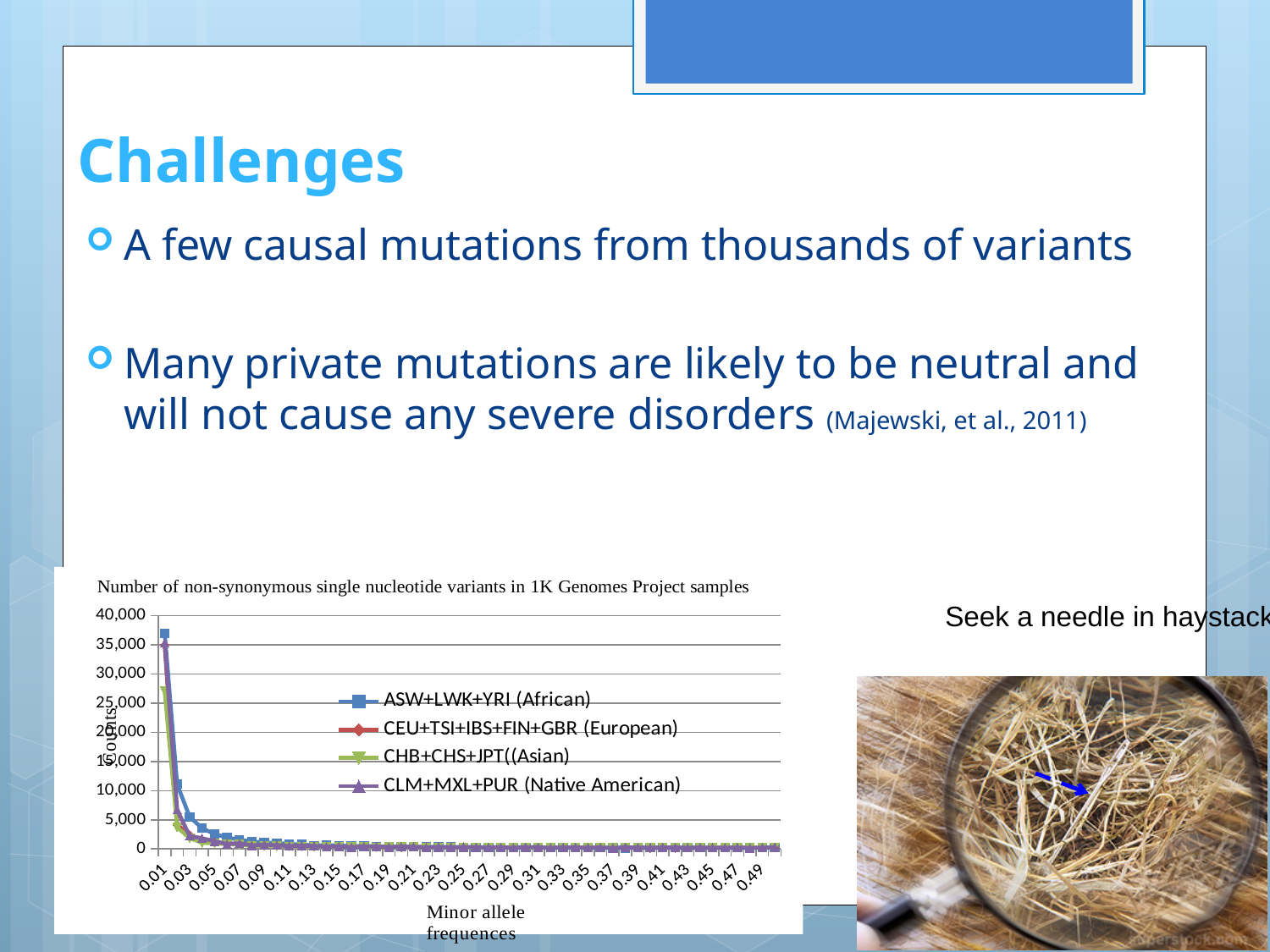
What is the highest value shown on the chart's y axis? 40,000 At minor allele frequency 0.01, which is larger: the count for ASW+LWK+YRI (African) or for CHB+CHS+JPT (Asian)? ASW+LWK+YRI (African) Is the value for CHB+CHS+JPT (Asian) at minor allele frequency 0.01 greater or less than 30,000? less Do the counts rise or fall as minor allele frequency increases along the x axis? fall What is the title of the chart? Number of non-synonymous single nucleotide variants in 1K Genomes Project samples Which legend entry is drawn with blue square markers? ASW+LWK+YRI (African) Which series has the lowest count at minor allele frequency 0.01? CHB+CHS+JPT (Asian) Is the value for CEU+TSI+IBS+FIN+GBR (European) at minor allele frequency 0.05 greater or less than 10,000? less Is the value for ASW+LWK+YRI (African) at minor allele frequency 0.01 greater or less than 35,000? greater What kind of chart is shown on the slide? line chart What is the label of the chart's x axis? Minor allele frequences How many series does the chart's legend list? 4